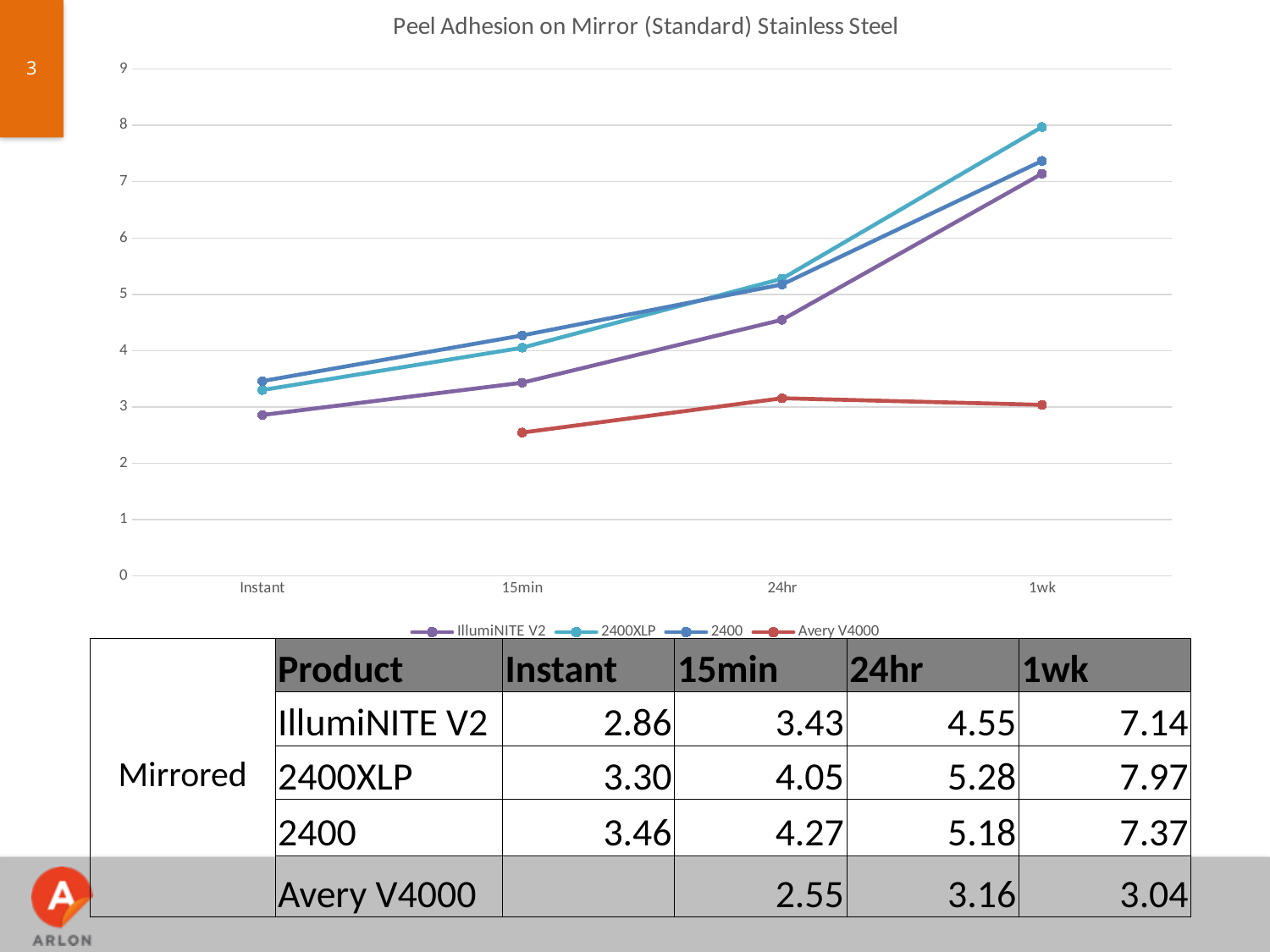
Do the values for 2400XLP rise or fall from Instant to 1wk? rise What is the value for 2400XLP at 1wk? 7.97 Which series has the lowest value at 15min? Avery V4000 How many categories are shown on the x axis? 4 How many series does the legend list? 4 Which series has the highest value at 1wk? 2400XLP Is the value for IllumiNITE V2 at 24hr greater or less than 4? greater What is the value for Avery V4000 at 24hr? 3.16 What is the value for IllumiNITE V2 at Instant? 2.86 At Instant, which is larger: the value for 2400 or the value for 2400XLP? 2400 What is the difference between the 2400XLP and IllumiNITE V2 values at 1wk? 0.83 What kind of chart is shown on the slide? line chart